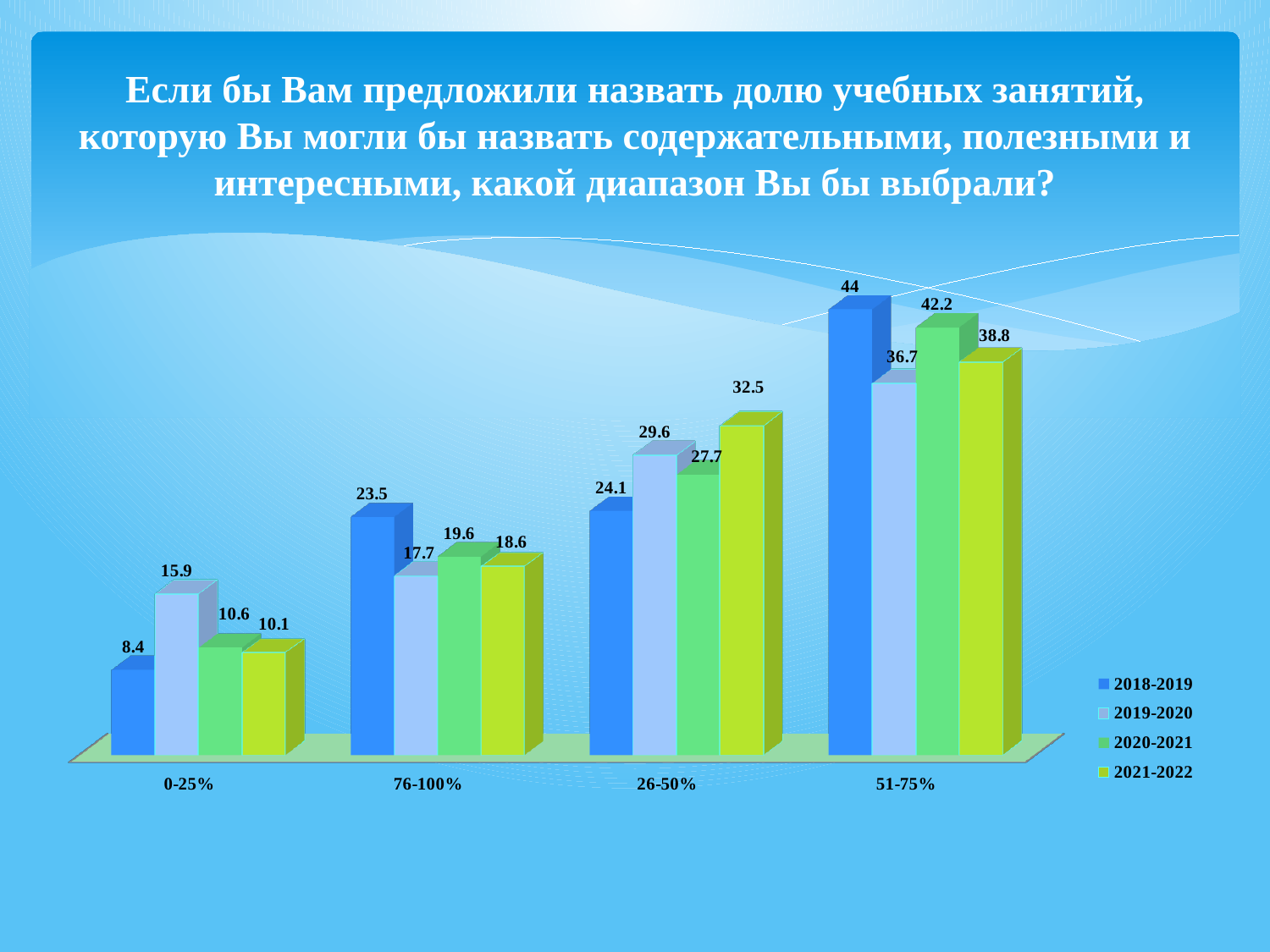
What is the value for 2020-2021 in the 76-100% category? 19.6 What is the value for 2021-2022 in the 26-50% category? 32.5 What is the value for 2018-2019 in the 51-75% category? 44 Which category has the highest value for the 2018-2019 series? 51-75% In the 76-100% category, which is larger: the 2018-2019 value or the 2019-2020 value? 2018-2019 How many series does the legend list? 4 What is the difference between the 2018-2019 and 2019-2020 values in the 51-75% category? 7.3 What is the difference between the 2021-2022 and 2018-2019 values in the 26-50% category? 8.4 Which category has the lowest value for the 2021-2022 series? 0-25% What is the value for 2019-2020 in the 0-25% category? 15.9 How many categories are shown on the x axis? 4 What kind of chart is shown on the slide? bar chart